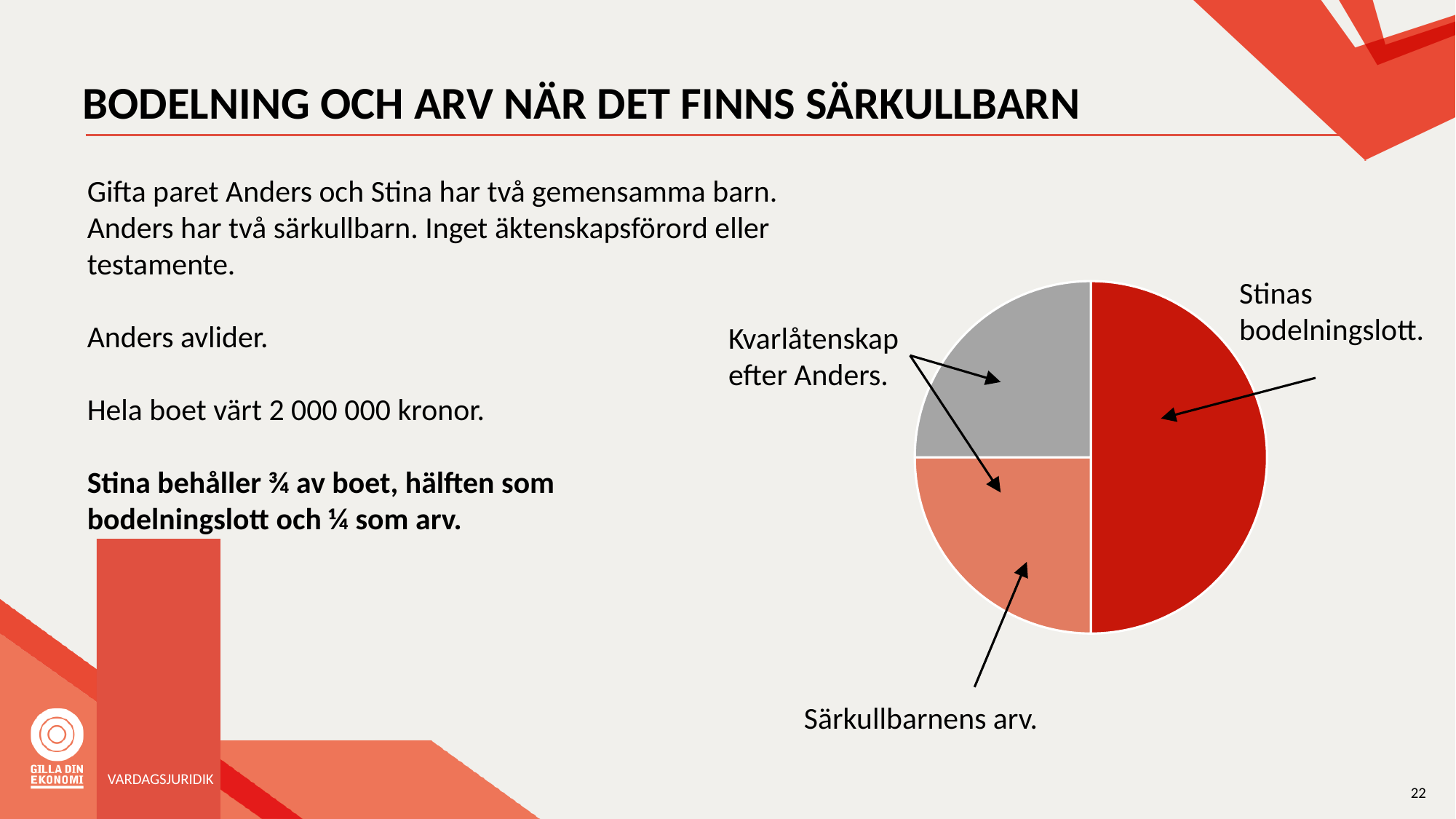
Which slice of the pie chart is the largest? Stinas bodelningslott What colour is the Stinas bodelningslott slice of the pie chart? dark red How many slices does the pie chart have? 3 What share of the pie does Särkullbarnens arv take up? ¼ Which label on the pie chart has two arrows pointing to slices? Kvarlåtenskap efter Anders. What share of the pie does Stinas bodelningslott take up? hälften Is the Stinas bodelningslott slice greater or less than a quarter of the pie? greater What kind of chart is shown on the slide? pie chart Which is larger in the pie chart, Stinas bodelningslott or Särkullbarnens arv? Stinas bodelningslott